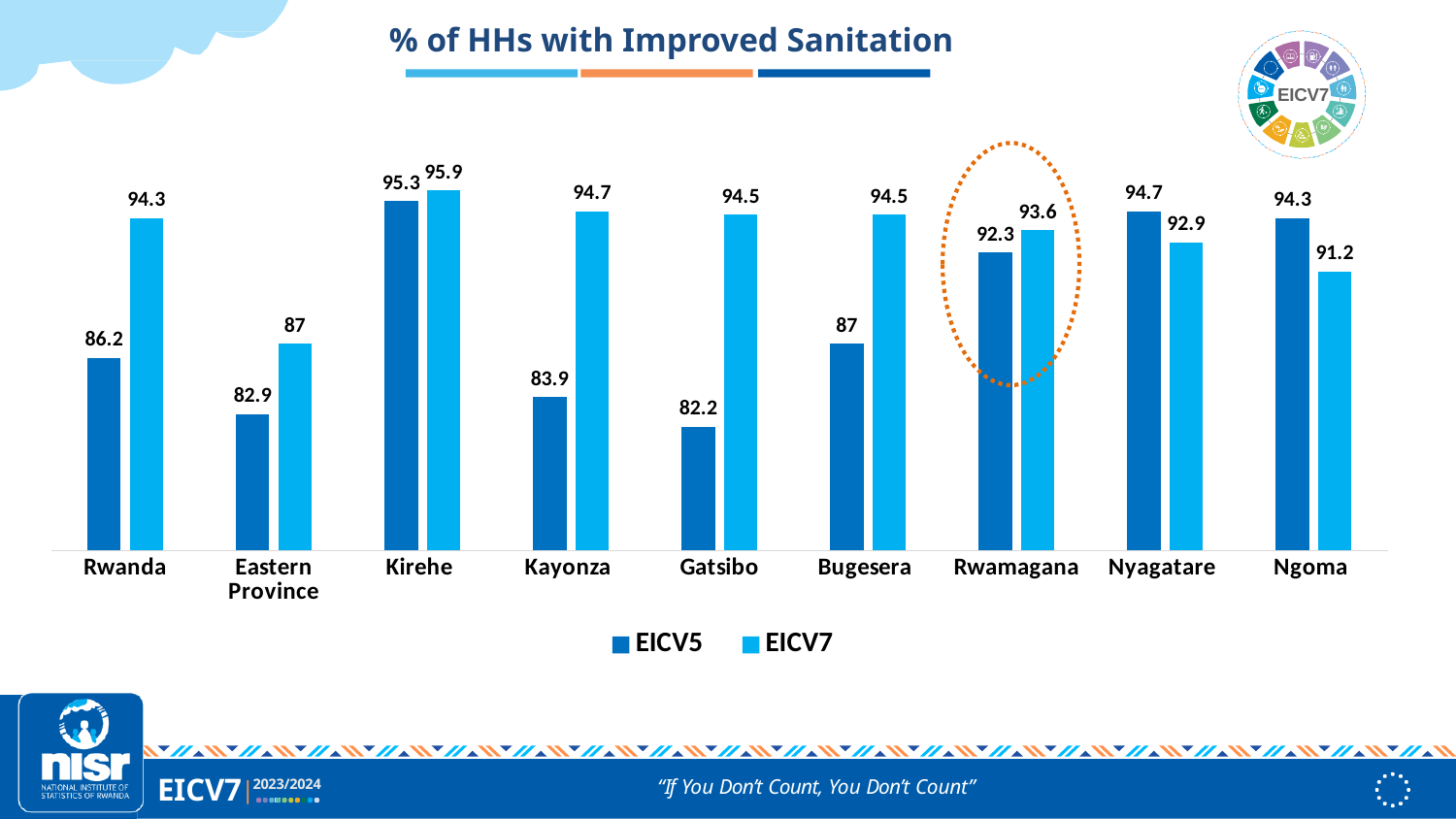
Which is larger for Nyagatare, the EICV5 value or the EICV7 value? EICV5 What is the difference between the EICV7 and EICV5 values for Kayonza? 10.8 What is the EICV7 value for Eastern Province? 87 Which category has the highest EICV7 value? Kirehe How many categories are shown on the x axis? 9 Which category is highlighted with a dotted orange circle? Rwamagana What is the EICV7 value for Kirehe? 95.9 What is the EICV5 value for Gatsibo? 82.2 What kind of chart is shown on the slide? Bar chart What is the title of the chart? % of HHs with Improved Sanitation Which category has the lowest EICV5 value? Gatsibo How many series does the legend list? 2